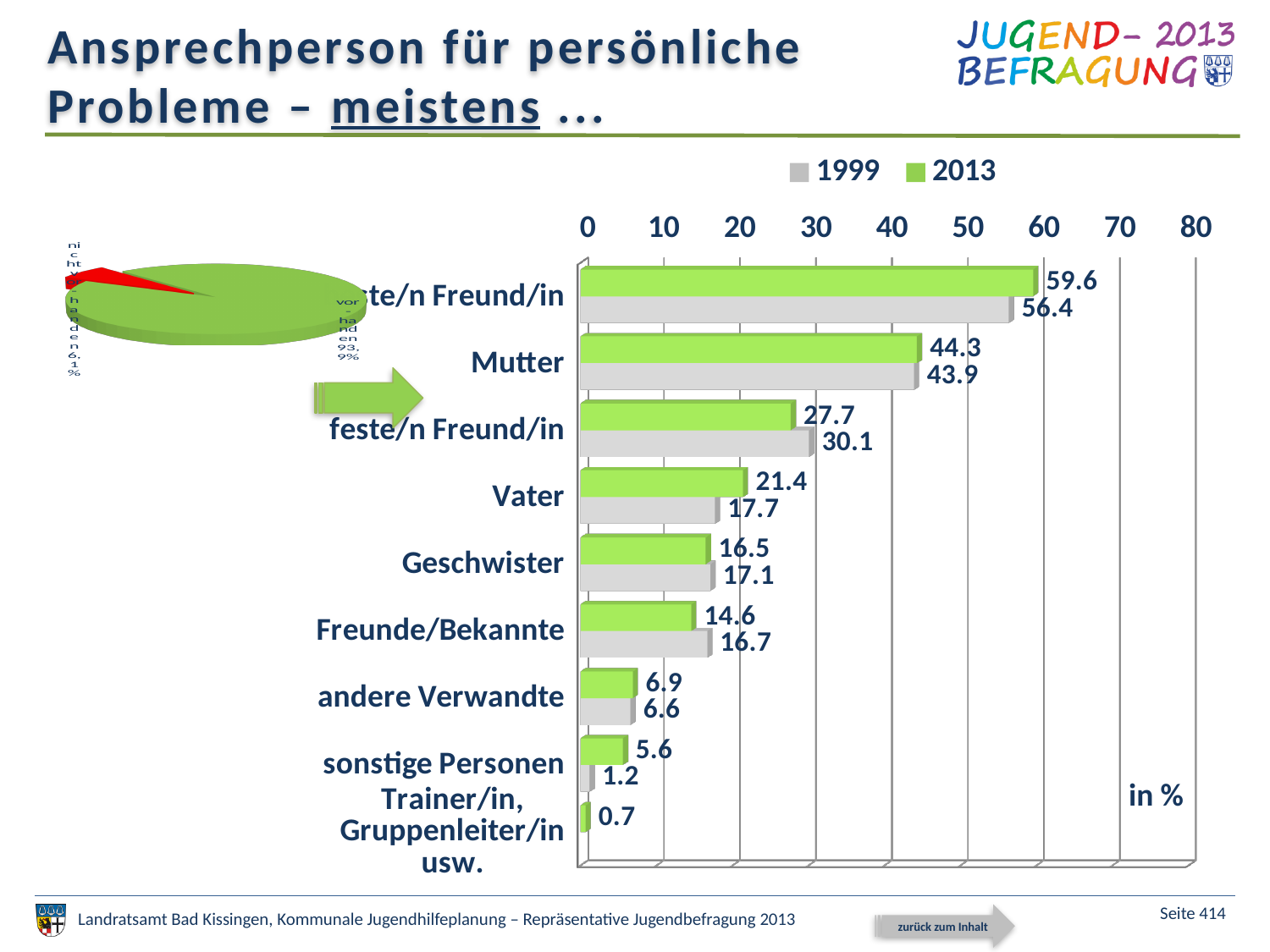
What kind of chart is the large chart on the right of the slide? bar chart How many series does the legend of the bar chart list? 2 In the bar chart, what is the 2013 value for Freunde/Bekannte? 14.6 In the bar chart, what is the 1999 value for sonstige Personen? 1.2 In the bar chart, what is the 2013 value for Geschwister? 16.5 How many categories are shown in the bar chart? 9 In the bar chart, which category has the lowest 2013 value? Trainer/in, Gruppenleiter/in usw. In the bar chart, for feste/n Freund/in, which year has the larger value, 1999 or 2013? 1999 In the bar chart, what is the 2013 value for Mutter? 44.3 In the bar chart, what is the difference between the 2013 and 1999 values for Vater? 3.7 In the bar chart, what is the 1999 value for Vater? 17.7 In the bar chart, what is the difference between the 2013 and 1999 values for Mutter? 0.4